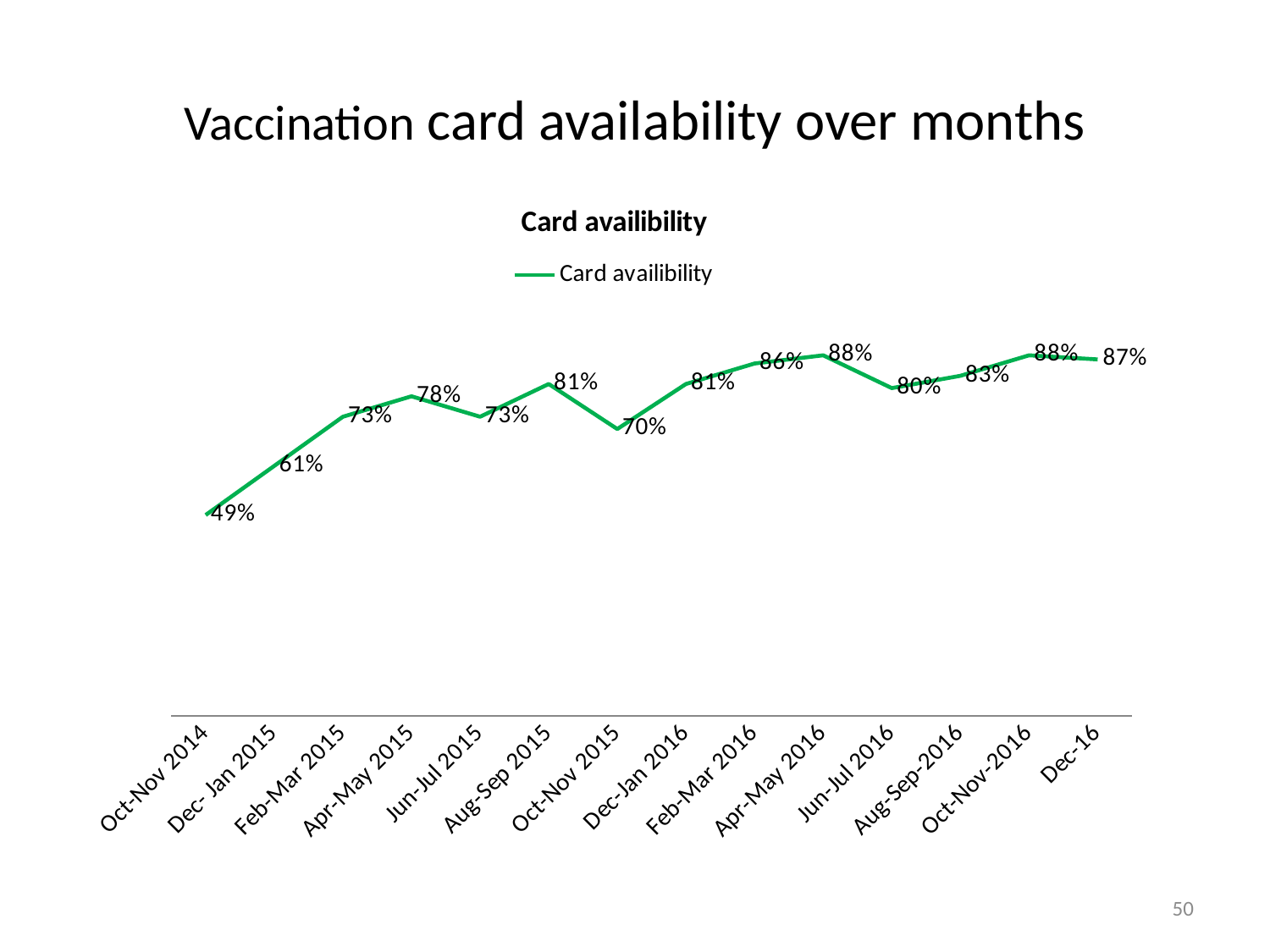
What is the card availability value for Oct-Nov 2015? 70% What is the difference in card availability between Dec-16 and Oct-Nov 2014? 38% How many time periods are plotted on the chart? 14 What is the card availability value for Jun-Jul 2016? 80% What is the highest card availability value shown on the chart? 88% Overall, does card availability rise or fall from Oct-Nov 2014 to Dec-16? Rise What is the difference in card availability between Aug-Sep 2015 and Oct-Nov 2015? 11% What kind of chart is shown on the slide? Line chart Which is larger, the card availability for Apr-May 2015 or for Jun-Jul 2015? Apr-May 2015 Which period has the lowest card availability? Oct-Nov 2014 What is the card availability value for Oct-Nov 2014? 49% What is the card availability value for Dec-16? 87%